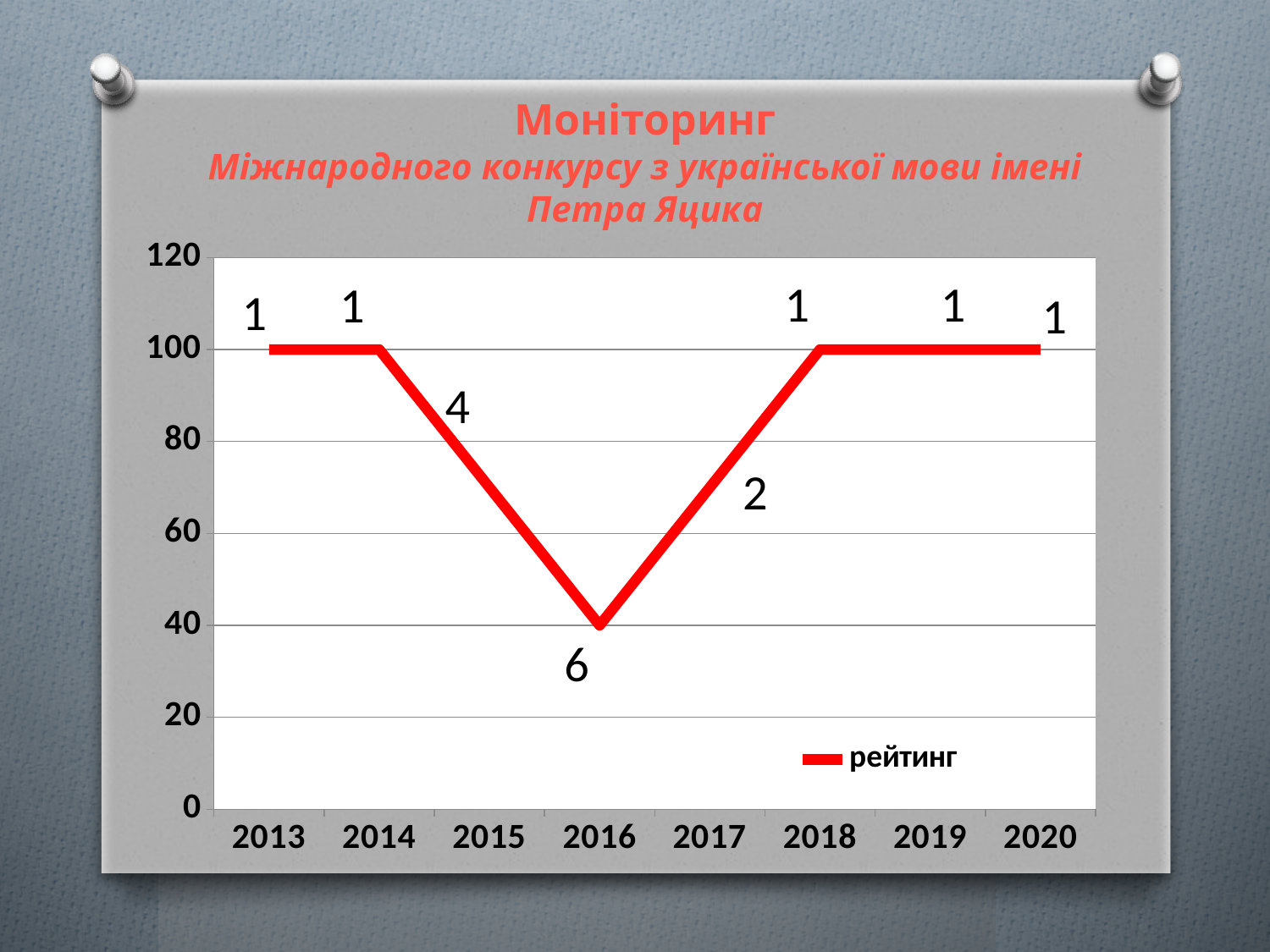
What is the data label for 2016? 6 In which year does the line reach its lowest point? 2016 What is the data label for 2015? 4 How many years are shown on the x axis? 8 What kind of chart is shown on the slide? line chart What is the difference between the data labels for 2016 and 2015? 2 Which year has the largest data label on the chart? 2016 What is the data label for 2013? 1 How many series does the legend list? 1 What is the data label for 2017? 2 Does the line rise or fall from 2013 to 2016? fall Which year has the larger data label, 2015 or 2017? 2015